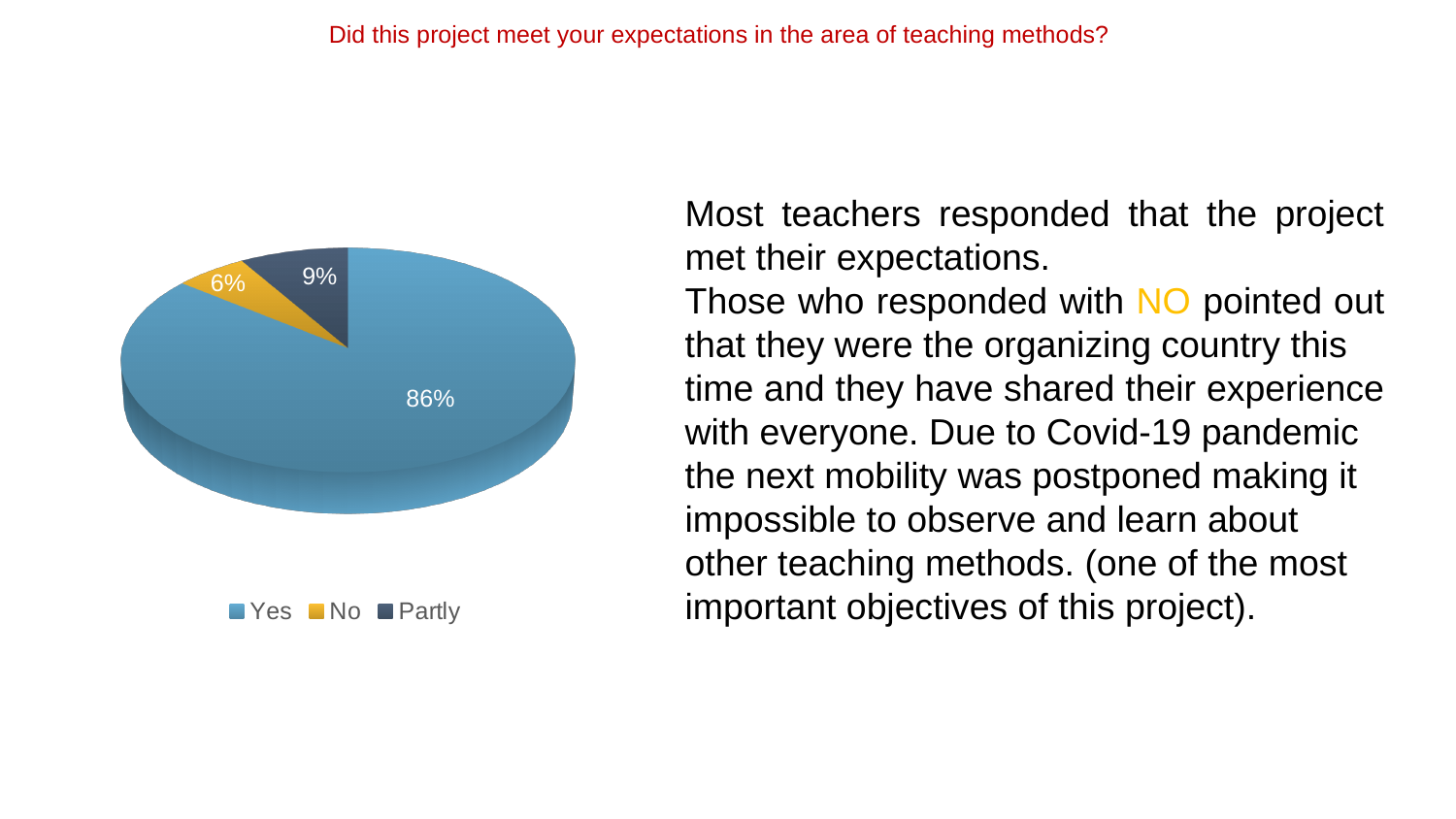
What question does the chart on the slide address? Did this project meet your expectations in the area of teaching methods? What kind of chart is shown on the slide? Pie chart Which response has the smallest share of the pie? No What percentage of respondents answered Yes? 86% What is the difference in percentage points between the Partly and No shares? 3 What percentage of respondents answered No? 6% How many slices does the pie chart have? 3 Which response has the largest share of the pie? Yes What percentage of respondents answered Partly? 9% What colour is the Yes slice in the pie chart? Blue Which is larger, the share for No or the share for Partly? Partly What is the difference in percentage points between the Yes and Partly shares? 77